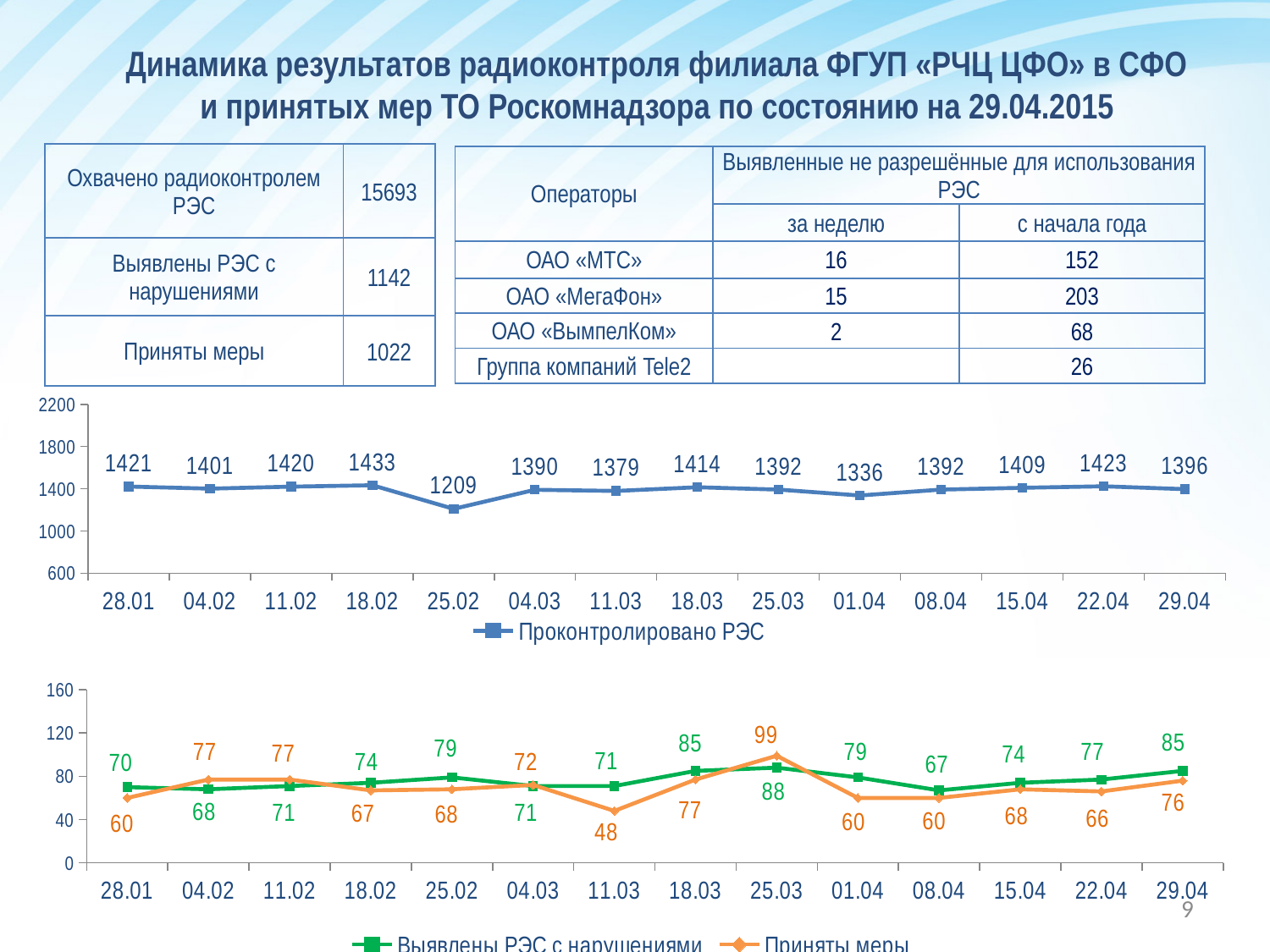
In the top chart (Проконтролировано РЭС), what is the difference between the values for 18.02 and 25.02? 224 In the top chart (Проконтролировано РЭС), which date has the highest value? 18.02 What type of chart is the top chart on the slide? Line chart In the top chart (Проконтролировано РЭС), which date has the lowest value? 25.02 How many series does the legend of the bottom chart list? 2 In the bottom chart, what is the difference between Выявлены РЭС с нарушениями and Приняты меры for 01.04? 19 In the top chart (Проконтролировано РЭС), how many data points are plotted? 14 In the bottom chart, which is larger for 11.03: Выявлены РЭС с нарушениями or Приняты меры? Выявлены РЭС с нарушениями In the bottom chart, what is the value of Выявлены РЭС с нарушениями for 08.04? 67 In the bottom chart, on which date is Приняты меры lowest? 11.03 In the bottom chart, what is the value of Приняты меры for 25.03? 99 In the top chart (Проконтролировано РЭС), what is the value for 25.02? 1209